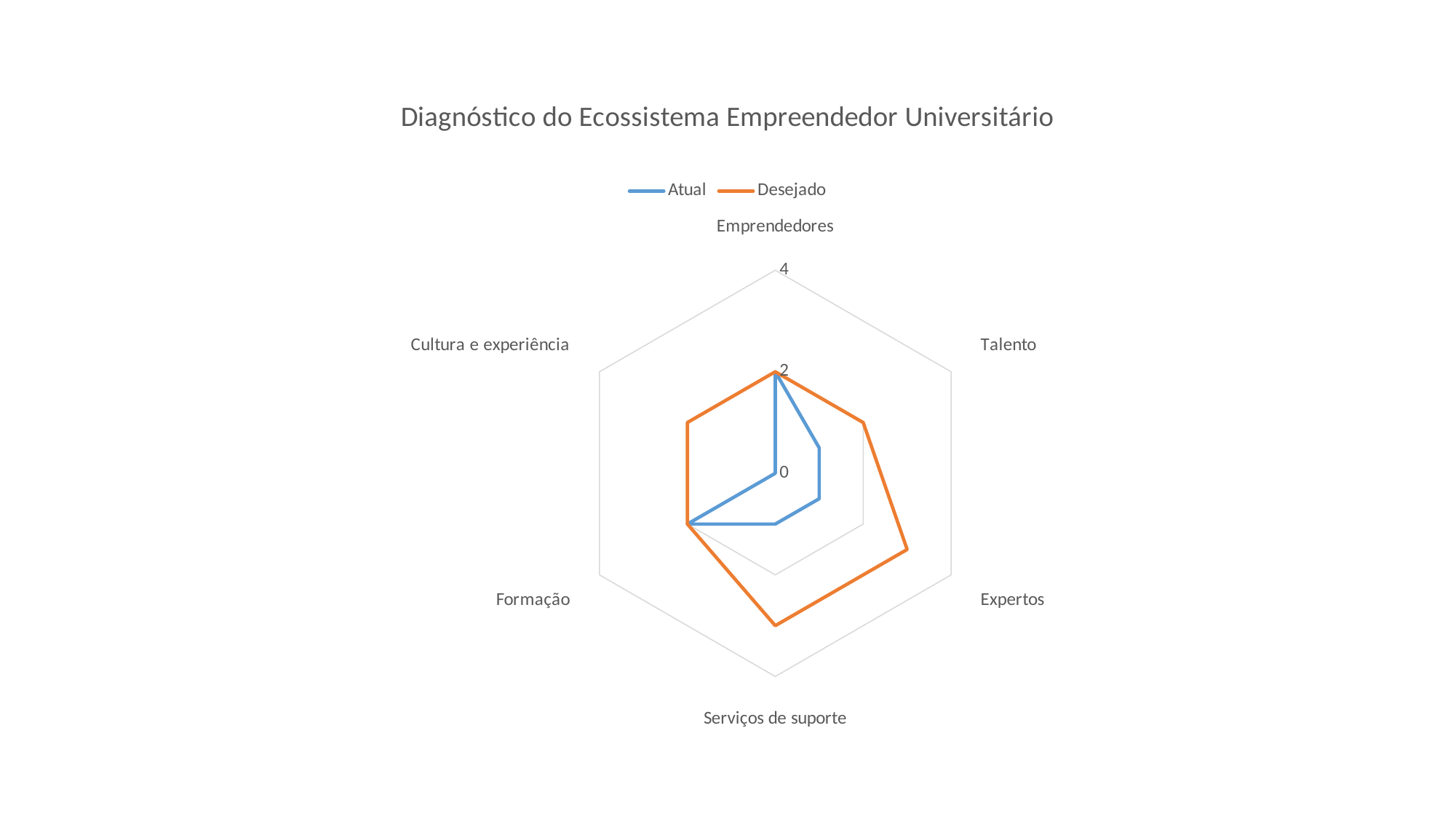
How many categories (axes) does the radar chart have? 6 For Serviços de suporte, which series has the larger value, Atual or Desejado? Desejado Which series is drawn in orange? Desejado What is the Atual value for Cultura e experiência? 0 What is the Desejado value for Emprendedores? 2 What is the title of the chart? Diagnóstico do Ecossistema Empreendedor Universitário What is the Atual value for Emprendedores? 2 How many series does the legend list? 2 What kind of chart is shown on the slide? Radar chart Which category has the lowest Atual value? Cultura e experiência Is the Atual value for Talento greater or less than 2? less Is the Desejado value for Expertos greater or less than 2? greater